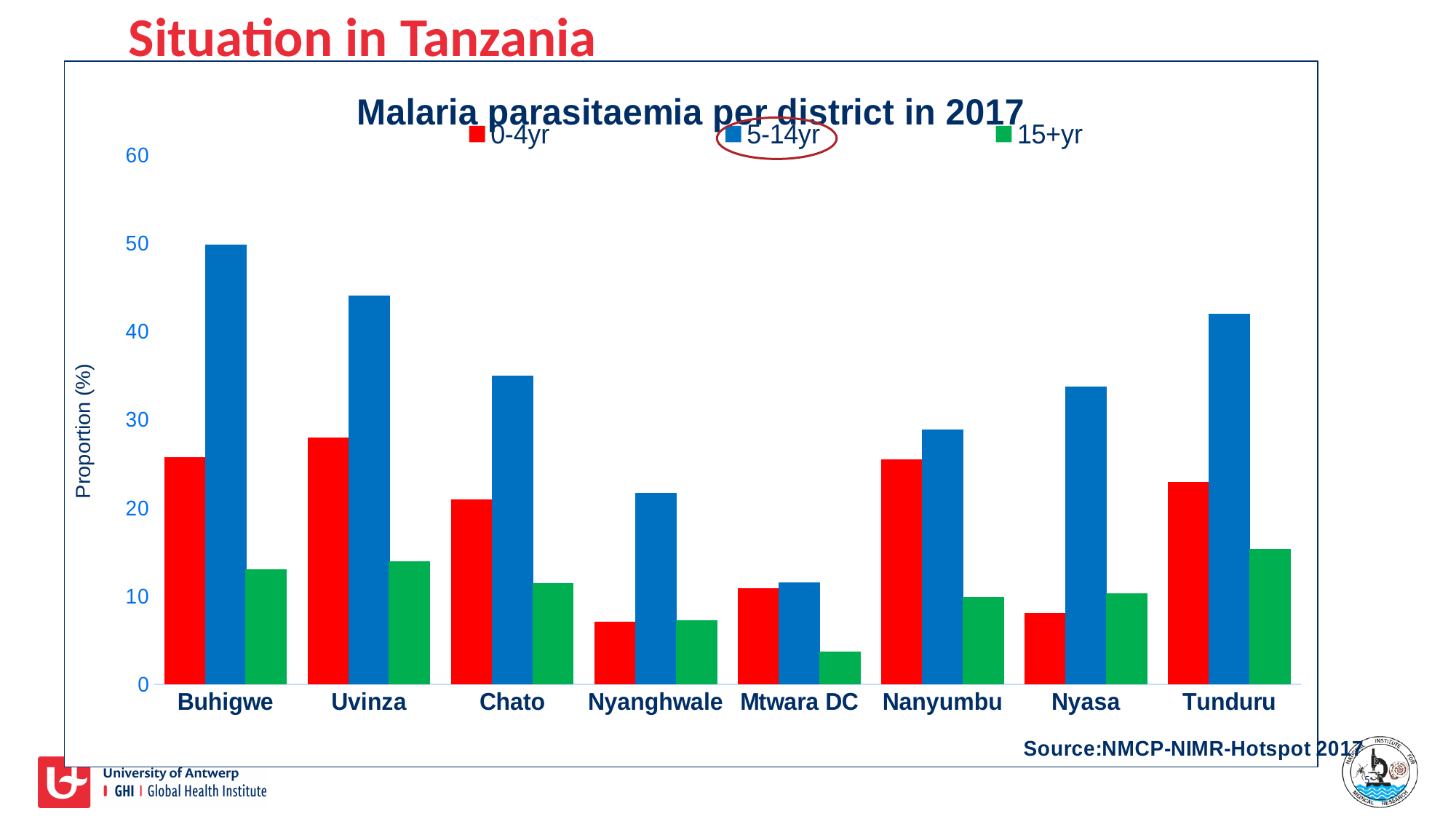
Is the 0-4yr value for Nyasa greater or less than 10? less What kind of chart is shown on the slide? bar chart How many districts are shown on the x axis? 8 Which district has the lowest value for the 15+yr series? Mtwara DC How many series does the legend list? 3 Which district has the highest value for the 0-4yr series? Uvinza Which district has the highest value for the 5-14yr series? Buhigwe Which is larger: the 0-4yr value for Uvinza or the 0-4yr value for Nyanghwale? Uvinza Which district has the lowest value for the 5-14yr series? Mtwara DC Is the 15+yr value for Tunduru greater or less than 20? less Is the 5-14yr value for Buhigwe greater or less than 40? greater What is the title of the chart? Malaria parasitaemia per district in 2017